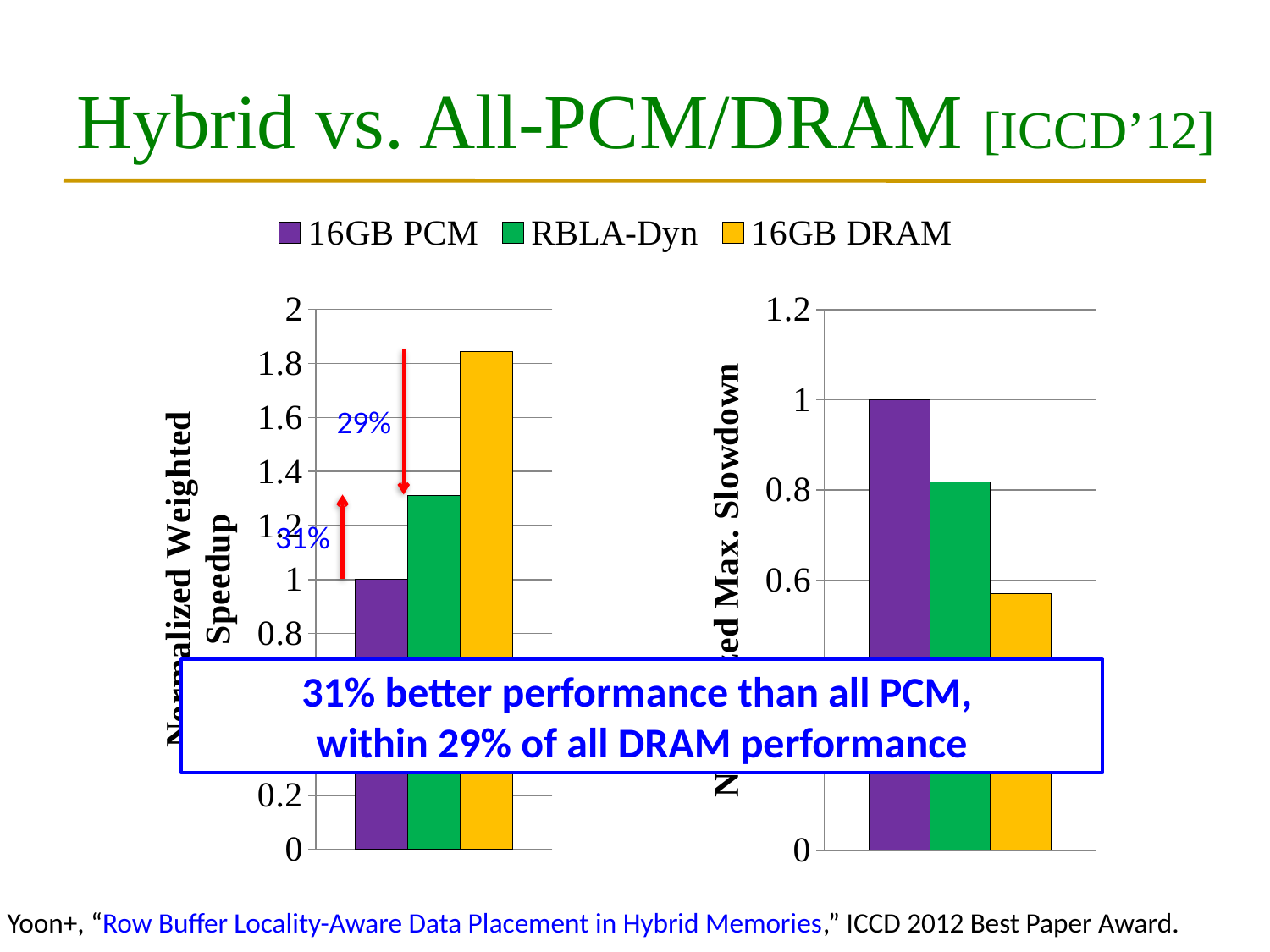
How many series does the legend list? 3 In the Normalized Max. Slowdown chart on the right, is the value for 16GB DRAM greater or less than 0.6? less In the Normalized Weighted Speedup chart on the left, is the value for RBLA-Dyn greater or less than 1.4? less In the Normalized Weighted Speedup chart on the left, which series has the highest value? 16GB DRAM In the Normalized Max. Slowdown chart on the right, what is the value for 16GB PCM? 1 In the Normalized Weighted Speedup chart on the left, is the value for 16GB DRAM greater or less than 1.8? greater In the Normalized Weighted Speedup chart on the left, which series has the lowest value? 16GB PCM In the Normalized Max. Slowdown chart on the right, which series has the lowest value? 16GB DRAM In the Normalized Max. Slowdown chart on the right, which series has the highest value? 16GB PCM What kind of chart is the Normalized Weighted Speedup chart on the left? Bar chart In the Normalized Weighted Speedup chart on the left, what is the value for 16GB PCM? 1